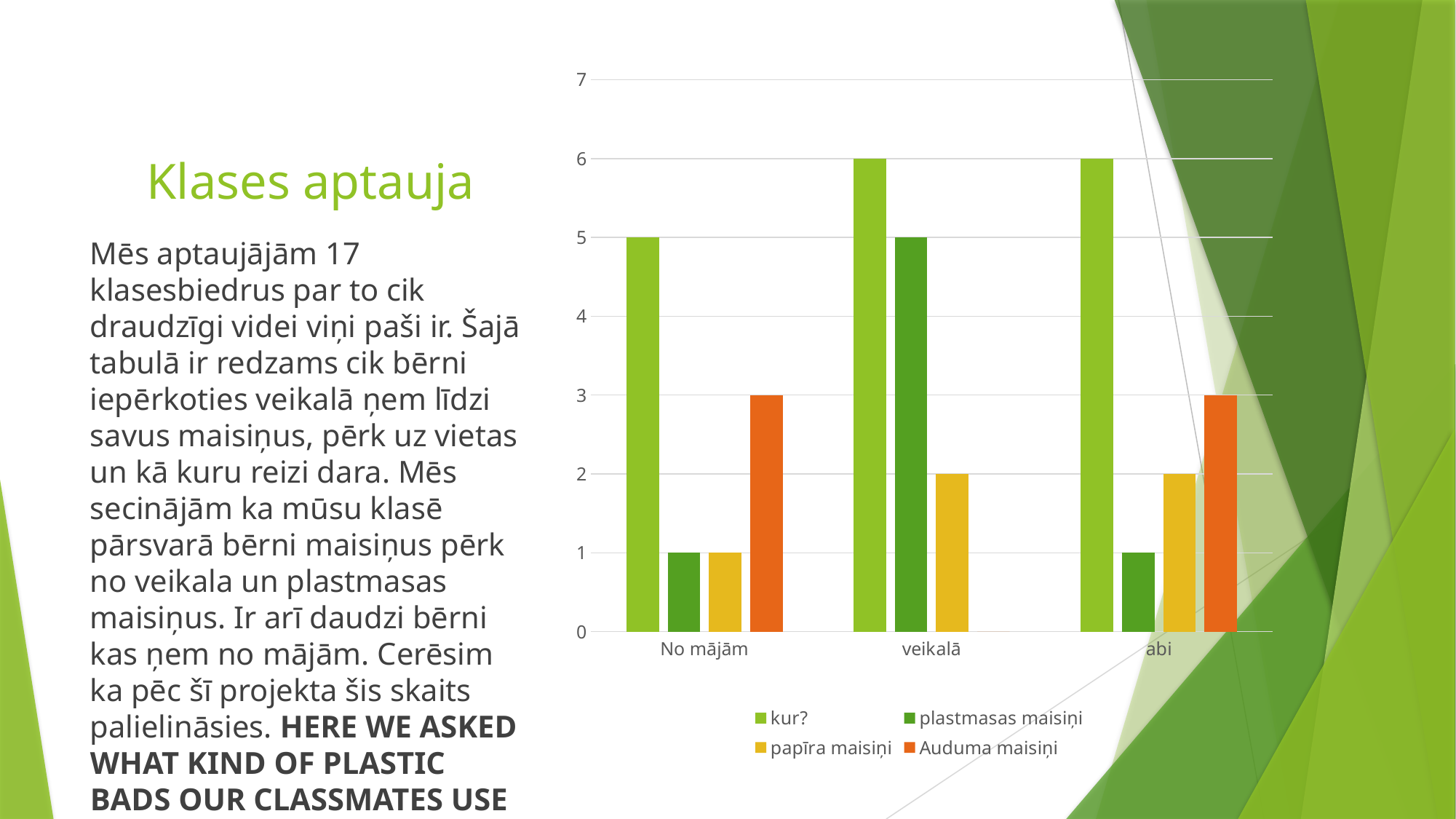
Which category has the lowest value for 'kur?'? No mājām What is the difference between 'plastmasas maisiņi' for 'veikalā' and for 'abi'? 4 What kind of chart is shown on the slide? bar chart What is the value of 'Auduma maisiņi' for 'abi'? 3 Which series is shown in orange in the chart legend? Auduma maisiņi What is the value of the 'kur?' series for 'No mājām'? 5 How many categories are shown on the x axis of the chart? 3 Which is larger: 'Auduma maisiņi' for 'No mājām' or 'papīra maisiņi' for 'No mājām'? Auduma maisiņi What is the value of 'papīra maisiņi' for 'No mājām'? 1 How many series does the chart legend list? 4 Which category has the highest value for 'plastmasas maisiņi'? veikalā What is the value of 'plastmasas maisiņi' for 'veikalā'? 5